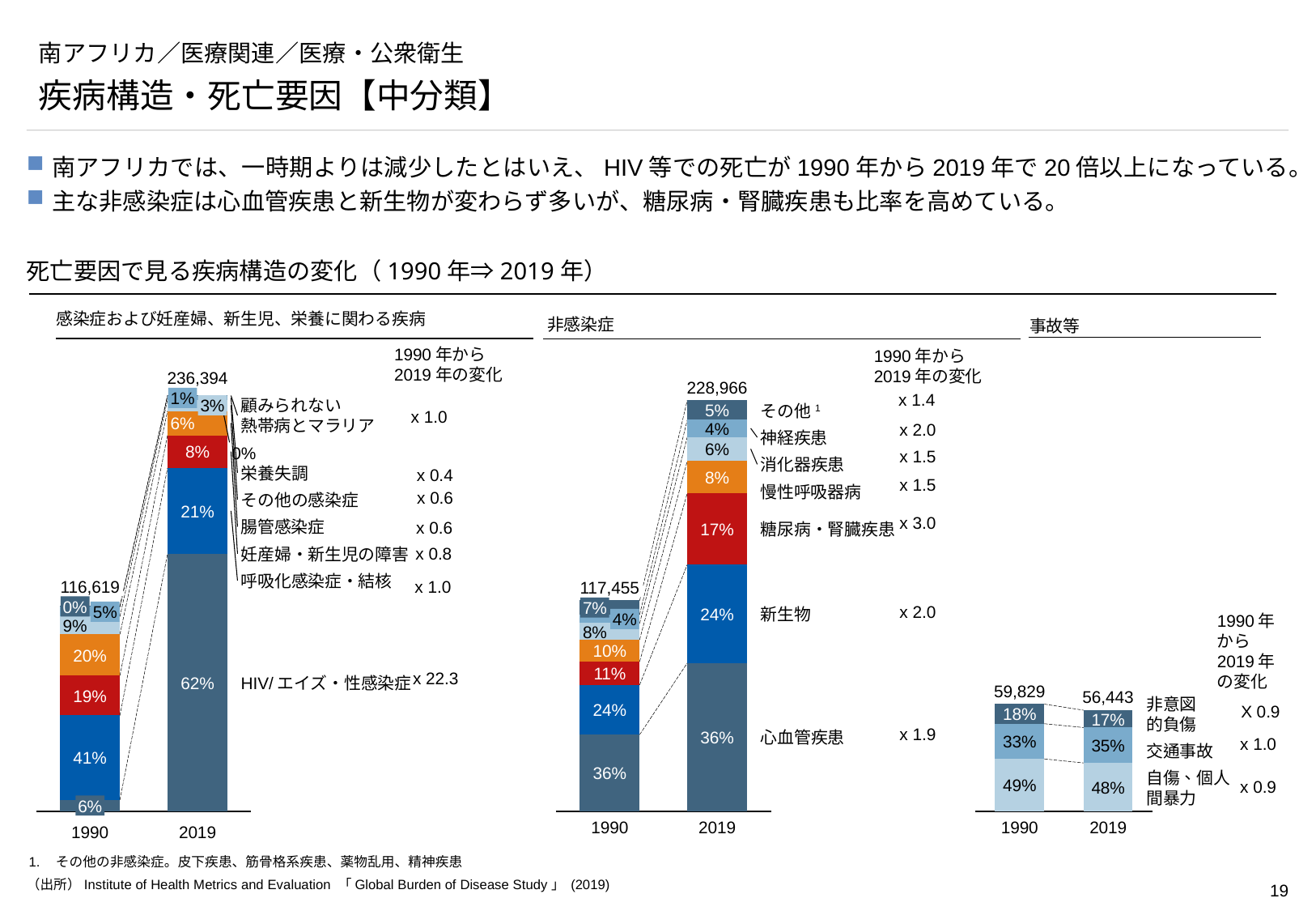
In the 事故等 chart, what percentage does 交通事故 account for in 2019? 35% In the 事故等 chart, what is the total value shown above the 1990 bar? 59,829 In the 非感染症 chart, what is the total value shown above the 2019 bar? 228,966 In the 感染症および妊産婦、新生児、栄養に関わる疾病 chart, what percentage does HIV/エイズ・性感染症 account for in 2019? 62% In the 非感染症 chart, what percentage does 心血管疾患 account for in 2019? 36% In the 事故等 chart, which category has the largest share in the 2019 bar? 自傷、個人間暴力 In the 感染症および妊産婦、新生児、栄養に関わる疾病 chart, what is the 1990年から2019年の変化 multiplier shown for HIV/エイズ・性感染症? x 22.3 In the 非感染症 chart, which has the larger share in 2019: 新生物 or 糖尿病・腎臓疾患? 新生物 In the 事故等 chart, does the total value rise or fall from 1990 to 2019? fall In the 非感染症 chart, what percentage does 糖尿病・腎臓疾患 account for in 2019? 17% In the 事故等 chart, what is the difference between the 1990 total (59,829) and the 2019 total (56,443)? 3,386 What kind of chart is used in the 非感染症 section of the slide? stacked bar chart